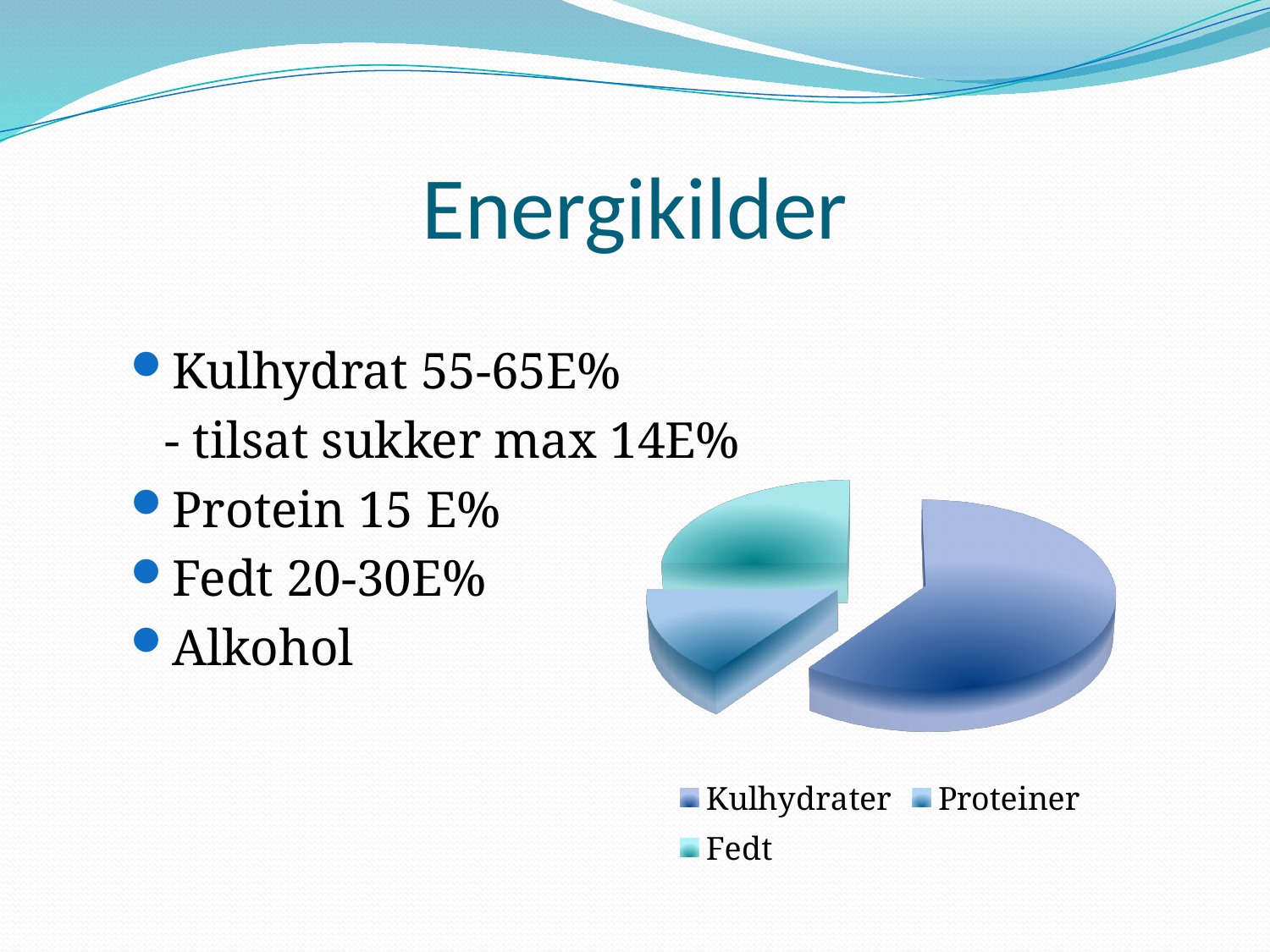
Which slice is larger in the pie chart, Fedt or Proteiner? Fedt Which legend entry of the pie chart is shown in teal/green? Fedt What kind of chart is shown on the slide? Pie chart How many entries does the legend of the pie chart list? 3 What are the legend entries of the pie chart? Kulhydrater, Proteiner, Fedt Which category has the largest slice in the pie chart? Kulhydrater Which slice is larger in the pie chart, Proteiner or Kulhydrater? Kulhydrater How many slices does the pie chart have? 3 Which slice is larger in the pie chart, Kulhydrater or Fedt? Kulhydrater Which category has the smallest slice in the pie chart? Proteiner